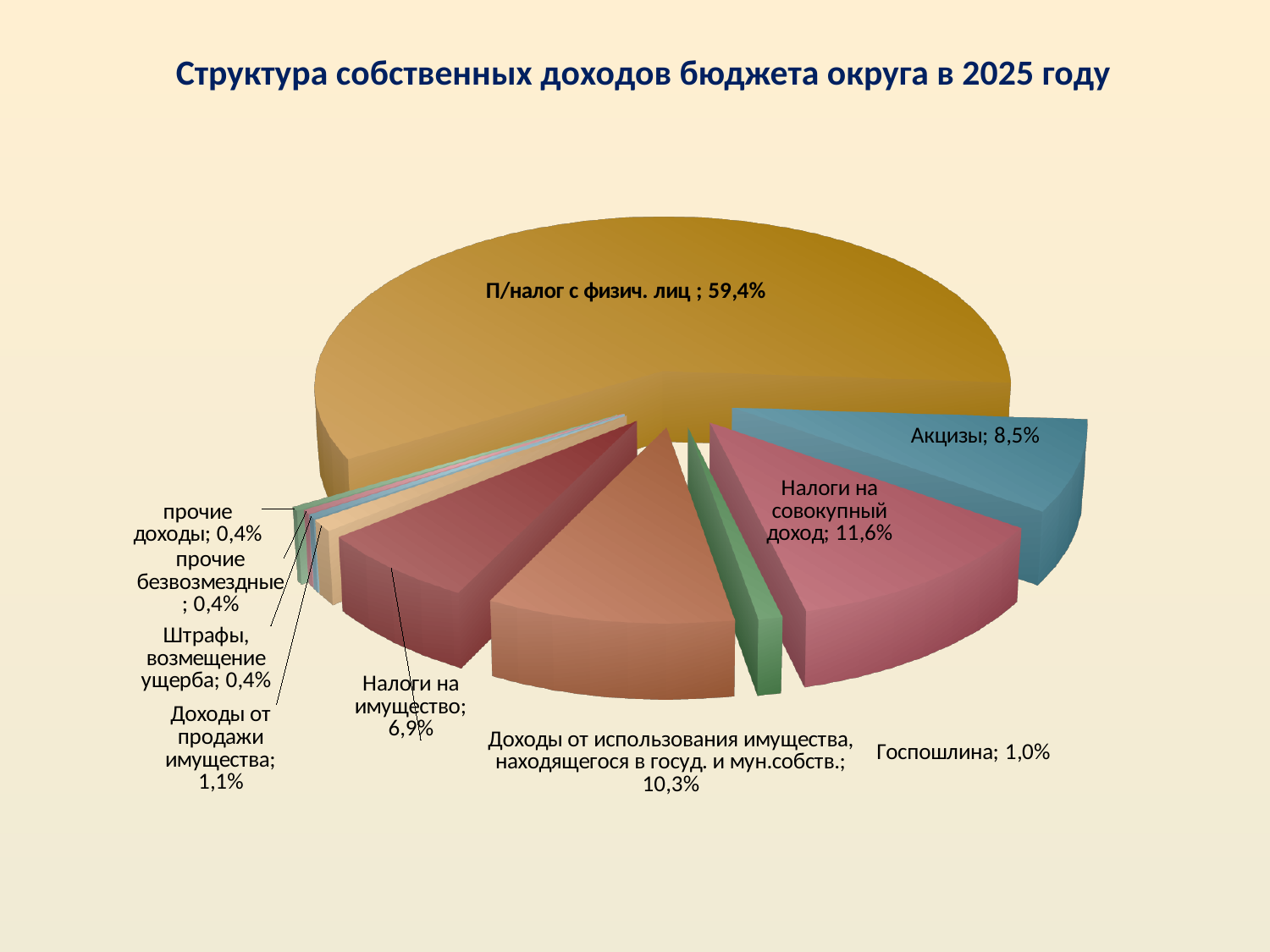
What share of the pie does "П/налог с физич. лиц" have? 59,4% What type of chart is shown on the slide? Pie chart What is the difference between the shares of "Налоги на совокупный доход" and "Акцизы"? 3,1% What is the value shown for "Акцизы"? 8,5% What is the value shown for "Налоги на имущество"? 6,9% How many slices does the pie chart have? 10 What is the value shown for "Доходы от продажи имущества"? 1,1% Which is larger: the share of "Доходы от использования имущества, находящегося в госуд. и мун.собств." or the share of "Налоги на имущество"? Доходы от использования имущества, находящегося в госуд. и мун.собств. Which category has the largest share of the pie? П/налог с физич. лиц What is the value shown for "Госпошлина"? 1,0% What is the value shown for "Налоги на совокупный доход"? 11,6% What is the title of the chart? Структура собственных доходов бюджета округа в 2025 году